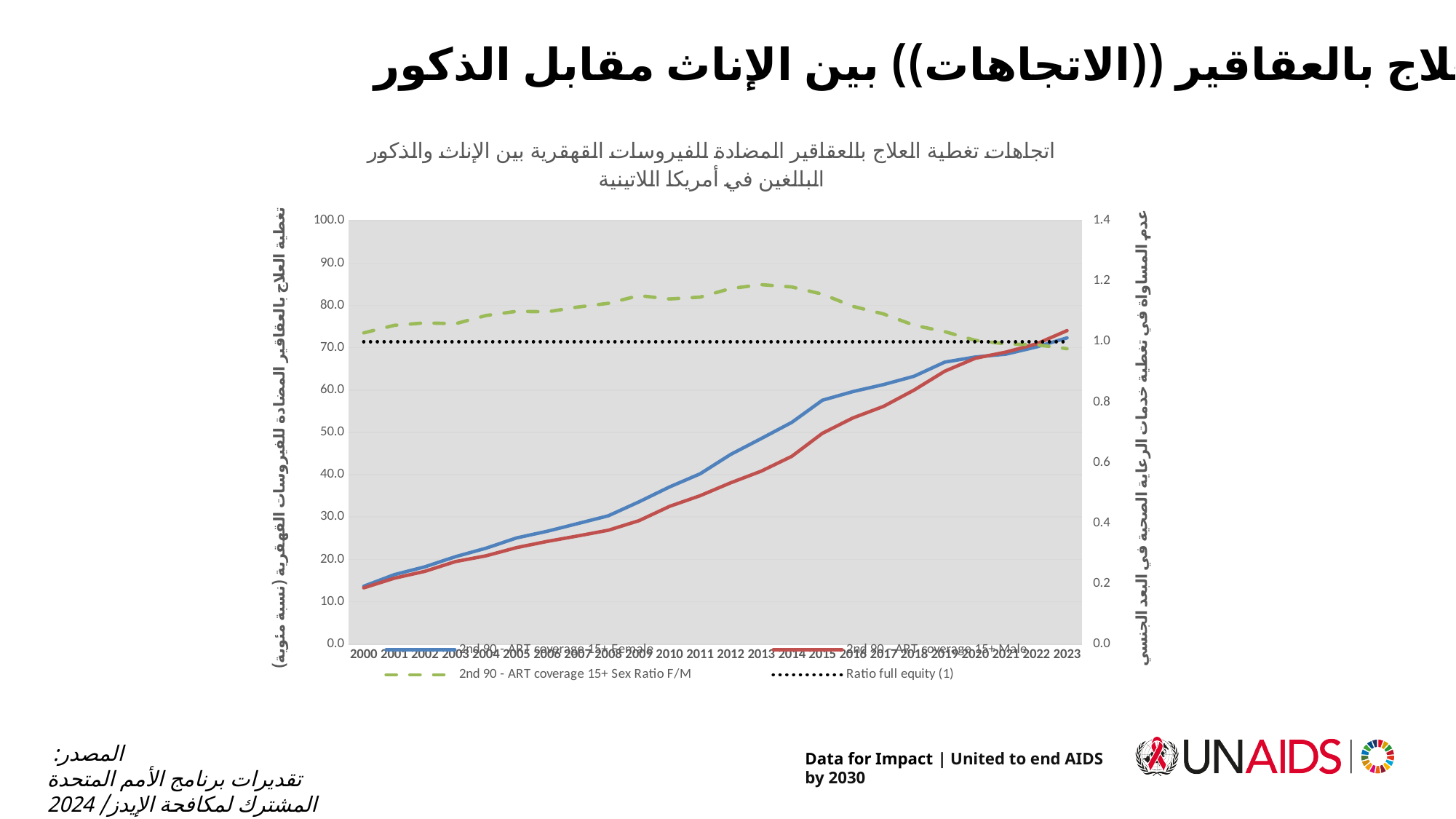
Does the '2nd 90 - ART coverage 15+ Sex Ratio F/M' line rise or fall from 2013 to 2023? fall Is the value for '2nd 90 - ART coverage 15+ Male' in 2010 greater or less than 30.0? greater In 2015, which is larger: '2nd 90 - ART coverage 15+ Female' or '2nd 90 - ART coverage 15+ Male'? 2nd 90 - ART coverage 15+ Female In which year is the '2nd 90 - ART coverage 15+ Female' value lowest? 2000 Is the value for '2nd 90 - ART coverage 15+ Sex Ratio F/M' in 2013 greater or less than 1.0 on the right axis? greater In which year is the '2nd 90 - ART coverage 15+ Male' value highest? 2023 Which legend entry is drawn as a black dotted line? Ratio full equity (1) How many years are shown along the x axis of the chart? 24 Is the value for '2nd 90 - ART coverage 15+ Female' in 2000 greater or less than 20.0? less Does the '2nd 90 - ART coverage 15+ Female' line rise or fall from 2000 to 2023? rise How many series does the chart legend list? 4 What kind of chart is shown on the slide? line chart